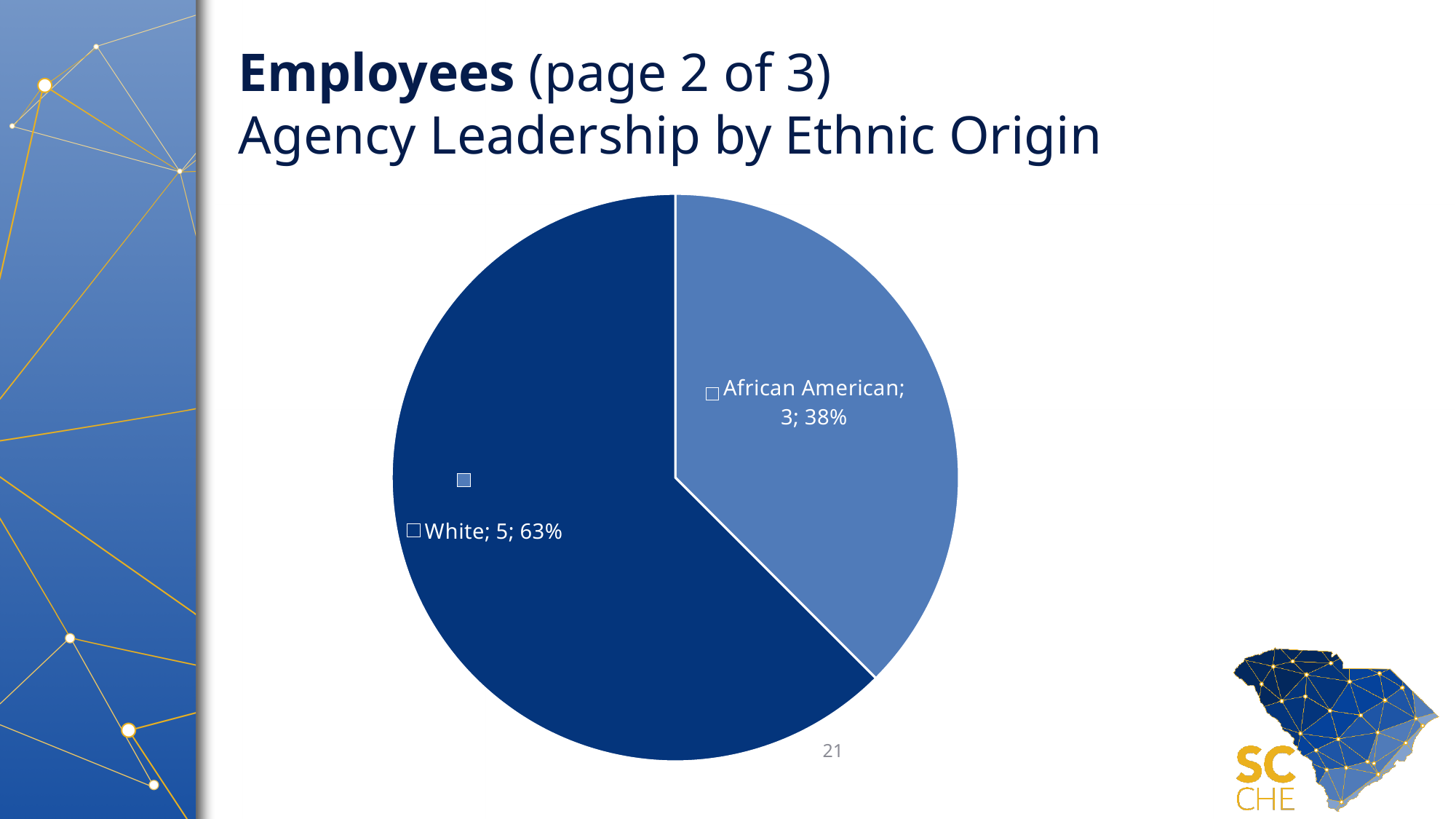
What is the count for White in the pie chart? 5 What percentage share does the African American slice represent? 38% What is the difference between the White count and the African American count? 2 Which category has the largest slice in the pie chart? White What is the count for African American in the pie chart? 3 How many slices does the pie chart have? 2 What is the title of the slide containing the pie chart? Employees (page 2 of 3) Agency Leadership by Ethnic Origin Which category has the smallest slice in the pie chart? African American Which is larger, the White slice or the African American slice? White What is the total count across both slices of the pie chart? 8 What percentage share does the White slice represent? 63% What kind of chart is shown on the slide? pie chart